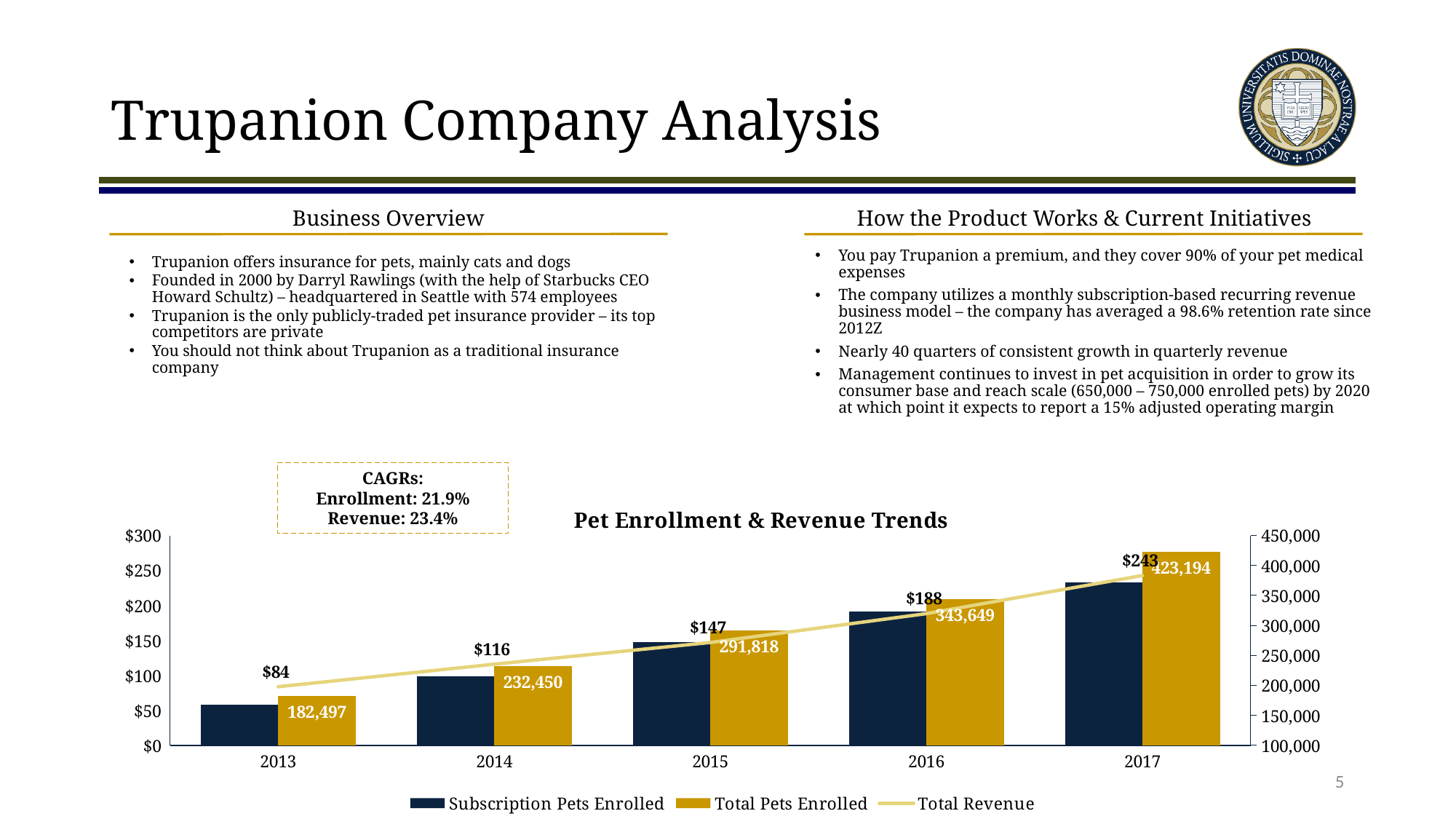
Which year has the highest Total Pets Enrolled? 2017 Does Total Revenue rise or fall from 2013 to 2017? rise What is the Total Revenue value for 2017 in the Pet Enrollment & Revenue Trends chart? $243 What is the Total Revenue value for 2013? $84 How many years are shown on the x axis of the chart? 5 Is the Subscription Pets Enrolled value for 2013 greater or less than 200,000? less How many series does the chart legend list? 3 Is the Subscription Pets Enrolled value for 2017 greater or less than 350,000? greater What is the Total Pets Enrolled value for 2015? 291,818 Which year has the lowest Total Revenue? 2013 What is the difference in Total Pets Enrolled between 2017 and 2016? 79,545 What is the difference in Total Revenue between 2015 and 2014? $31